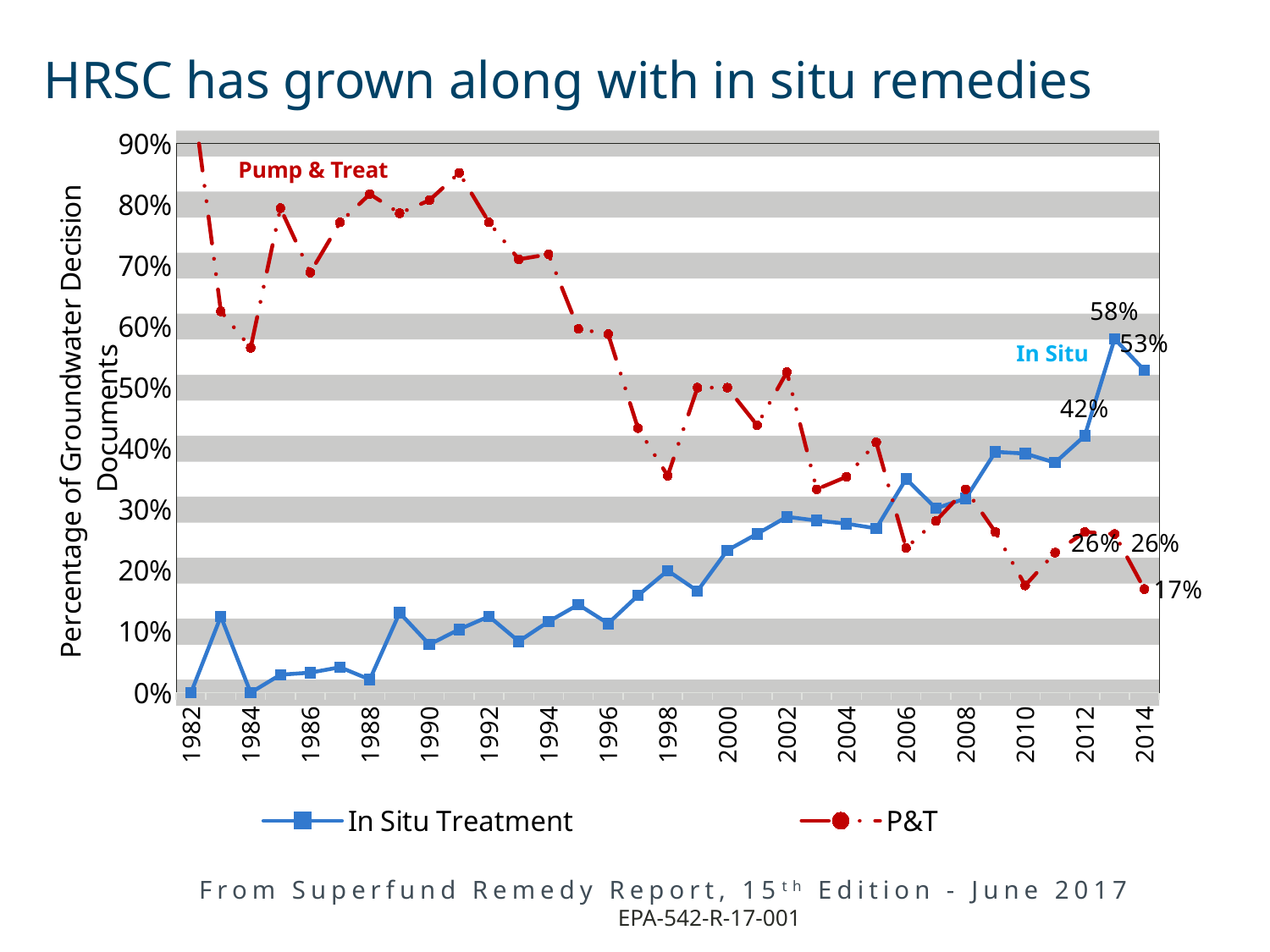
Is the value for In Situ Treatment in 1998 greater or less than 30%? less What is the difference between the In Situ Treatment and P&T values in 2014? 36 percentage points What is the value for P&T in 2014? 17% How many series does the legend list? 2 What is the value for In Situ Treatment in 2014? 53% What is the value for P&T in 2012? 26% Does the P&T series generally rise or fall from 1982 to 2014? Fall What is the value for In Situ Treatment in 2012? 42% What kind of chart is shown on the slide? Line chart What is the value for In Situ Treatment in 2013? 58% Is the value for P&T in 1991 greater or less than 80%? greater In 2014, which series has the larger value, In Situ Treatment or P&T? In Situ Treatment